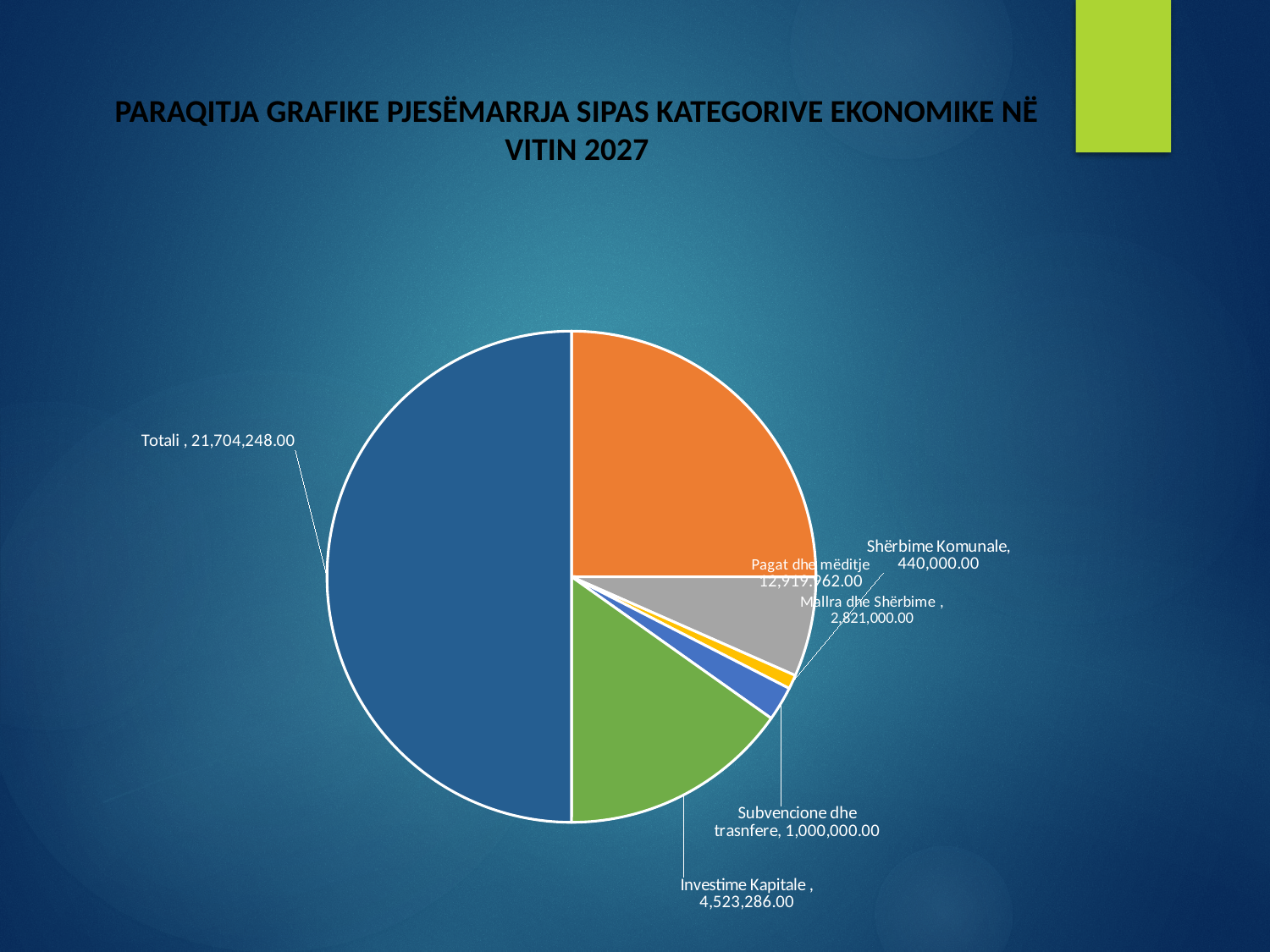
Which slice of the pie has the largest value? Totali What is the difference between the values for Investime Kapitale and Mallra dhe Shërbime? 1,702,286.00 What is the value shown for Subvencione dhe trasnfere? 1,000,000.00 How many slices does the pie chart have? 6 What is the value shown for Shërbime Komunale? 440,000.00 What is the value shown for Mallra dhe Shërbime? 2,821,000.00 Which is larger, the value for Mallra dhe Shërbime or the value for Subvencione dhe trasnfere? Mallra dhe Shërbime What colour is the Totali slice of the pie? blue Which slice of the pie has the smallest value? Shërbime Komunale What is the value shown for Totali? 21,704,248.00 What is the value shown for Investime Kapitale? 4,523,286.00 What kind of chart is shown on the slide? pie chart